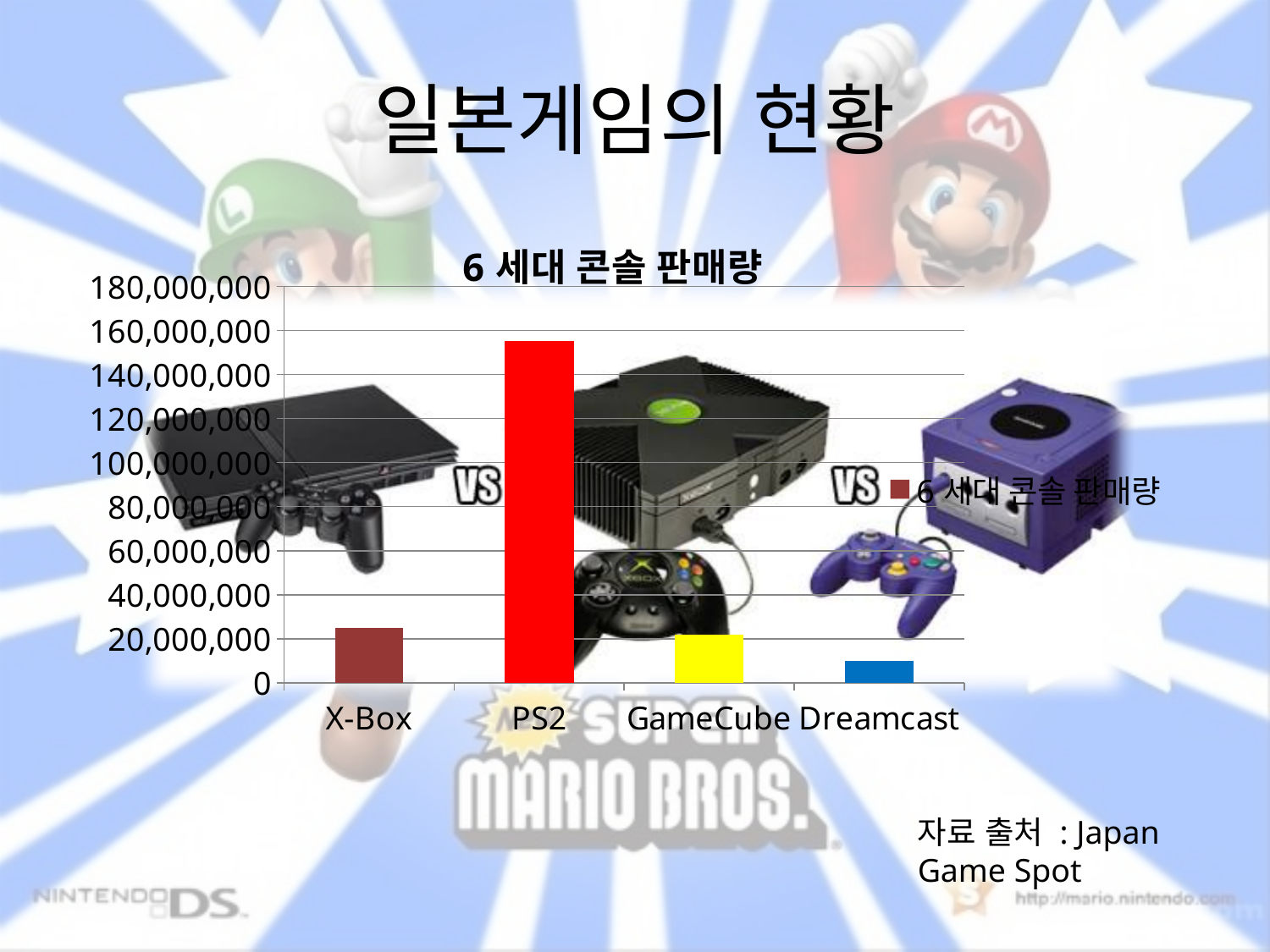
Which has higher sales, PS2 or X-Box? PS2 Is the value for PS2 greater or less than 140,000,000? greater What is the title of the chart? 6 세대 콘솔 판매량 Which console has the lowest sales in the chart? Dreamcast Is the value for X-Box greater or less than 40,000,000? less Is the value for GameCube greater or less than 40,000,000? less Which has higher sales, GameCube or Dreamcast? GameCube What kind of chart is shown on the slide? bar chart How many series does the chart legend list? 1 How many consoles are shown on the x axis of the chart? 4 Which console has the highest sales in the chart? PS2